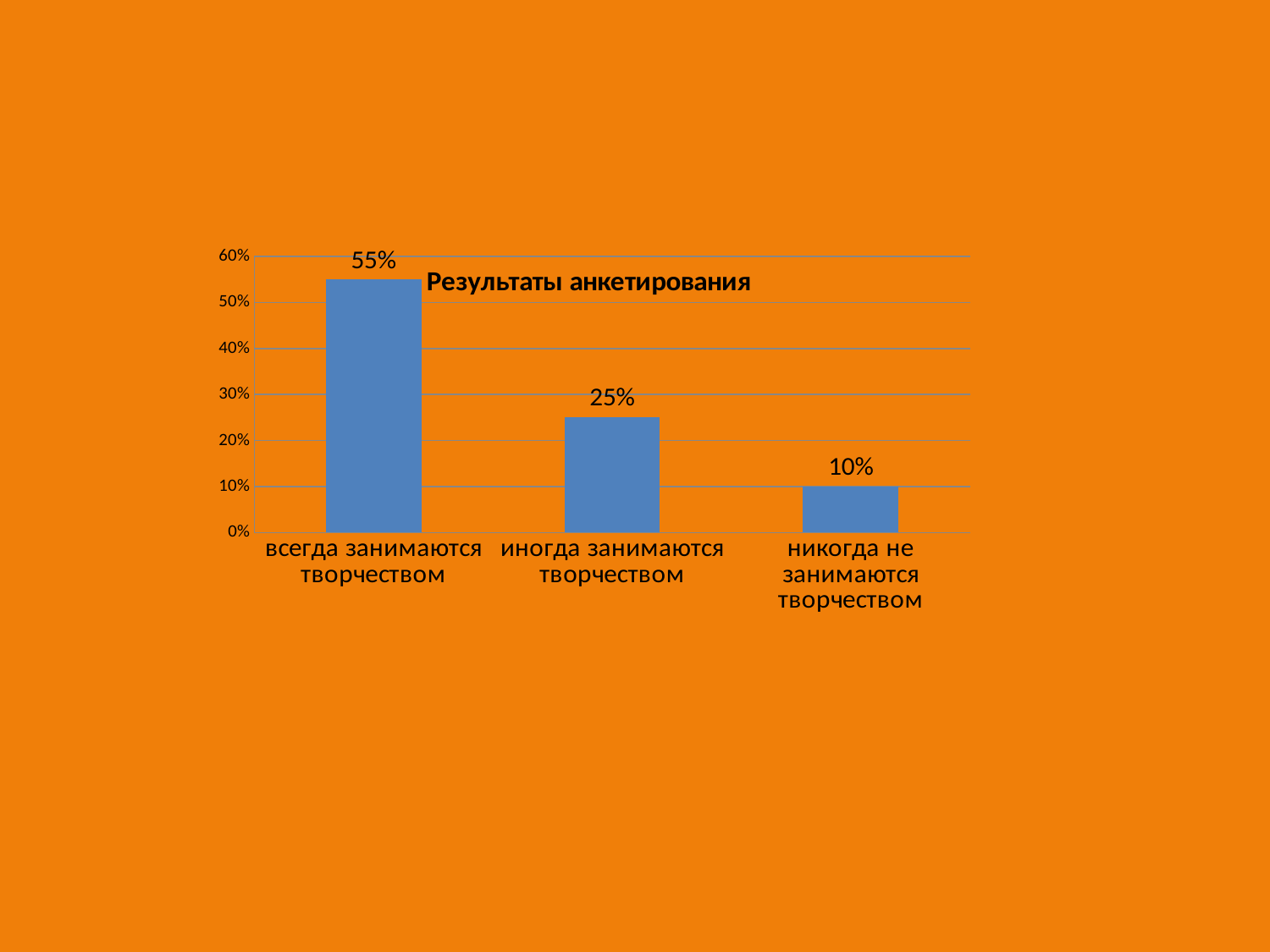
What is the difference between the values for "всегда занимаются творчеством" and "иногда занимаются творчеством"? 30% What is the value for "иногда занимаются творчеством"? 25% Which category has the highest value? всегда занимаются творчеством Which category has the lowest value? никогда не занимаются творчеством Is the value for "всегда занимаются творчеством" greater or less than 50%? greater What is the difference between the values for "иногда занимаются творчеством" and "никогда не занимаются творчеством"? 15% Which is larger: the value for "иногда занимаются творчеством" or "никогда не занимаются творчеством"? иногда занимаются творчеством What is the value for "никогда не занимаются творчеством"? 10% What kind of chart is shown on the slide? bar chart What is the value for "всегда занимаются творчеством"? 55% How many categories are shown on the chart? 3 What is the title of the chart? Результаты анкетирования